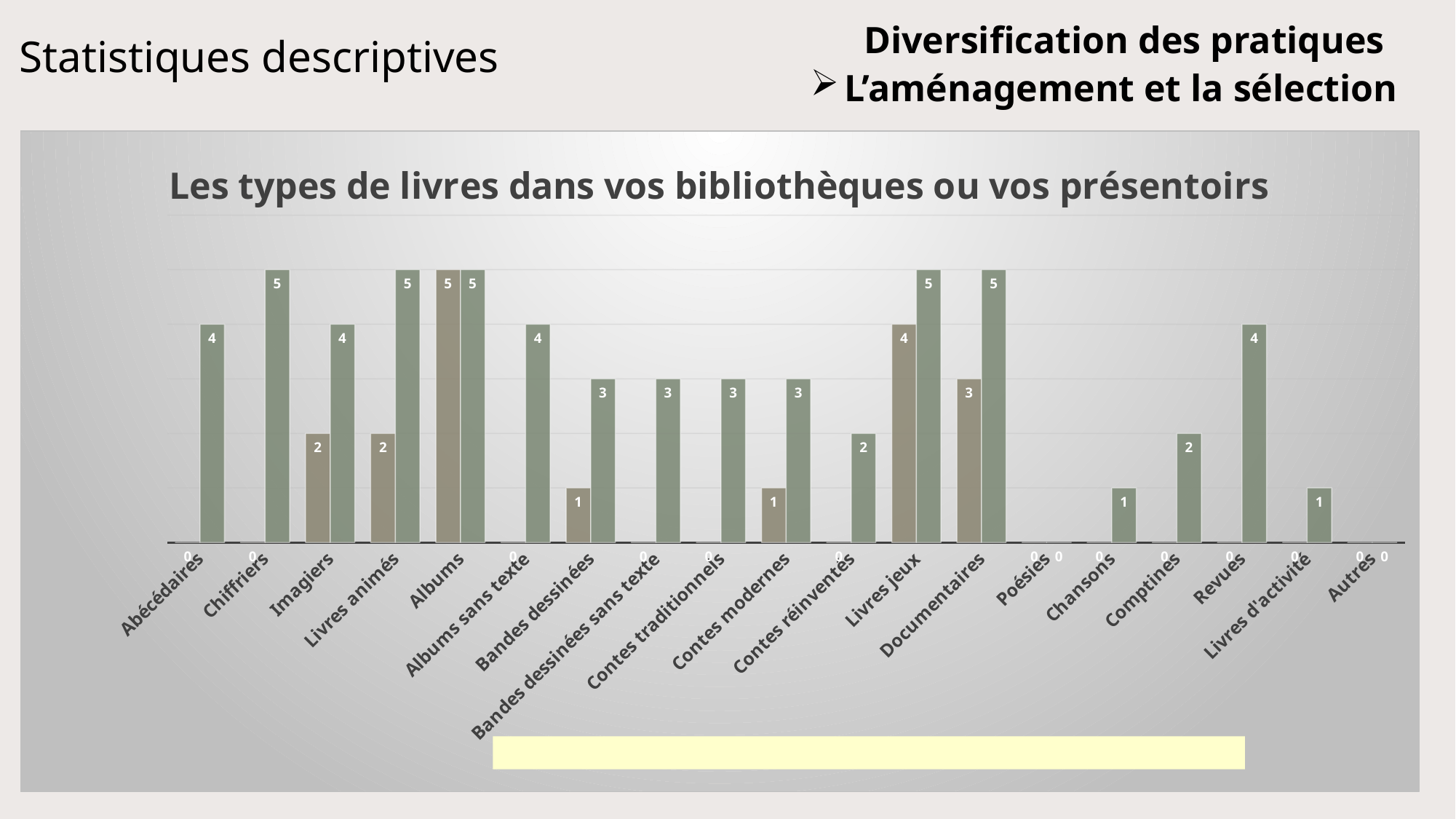
What is the title of the chart? Les types de livres dans vos bibliothèques ou vos présentoirs What is the value of the brown (first) bar for Livres jeux? 4 Which is larger for Bandes dessinées: the brown (first) bar or the green (second) bar? the green (second) bar What is the value of the brown (first) bar for Albums? 5 What is the value of the green (second) bar for Chansons? 1 What type of chart is shown on the slide? bar chart How many categories are shown along the x axis of the chart? 19 What is the value of the green (second) bar for Chiffriers? 5 What is the value of the brown (first) bar for Documentaires? 3 What is the difference between the green bar and the brown bar for Imagiers? 2 Which category has the lowest value for the green (second) bar, tied with Autres? Poésies What is the value of the green (second) bar for Contes réinventés? 2